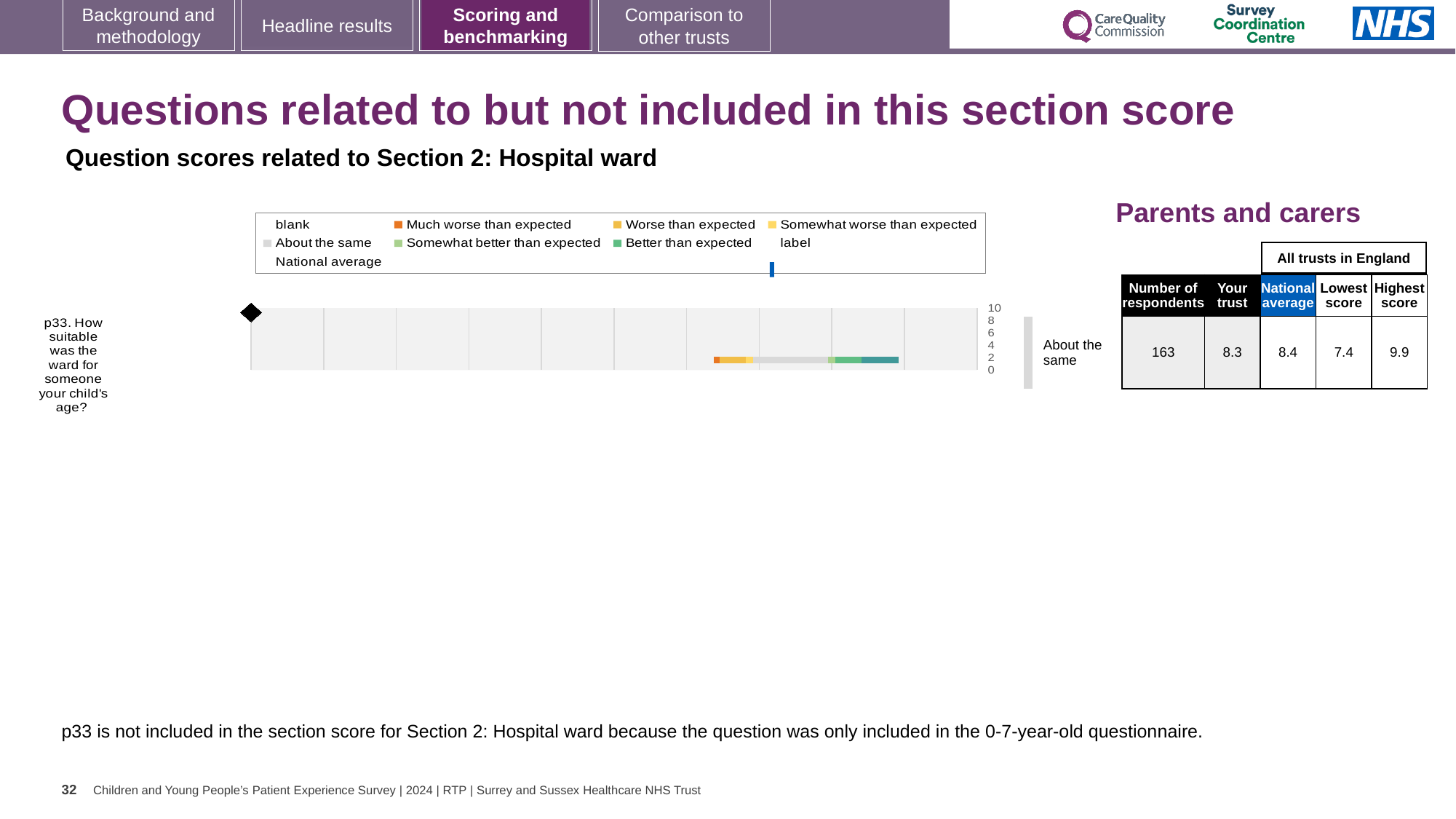
In the table beside the chart, what is the national average score for p33? 8.4 What is the highest value shown on the chart's axis? 10 Which question is plotted in the chart? p33. How suitable was the ward for someone your child's age? How many question categories are plotted in the chart? 1 In the table beside the chart, how many respondents answered p33? 163 Which is larger for p33, the 'Your trust' score or the national average? national average How many entries does the chart legend list? 9 What kind of chart is shown on the slide? bar chart In the table beside the chart, what is the 'Your trust' score for p33? 8.3 What benchmark category label is shown to the right of the chart for p33? About the same In the table beside the chart, what is the lowest score among all trusts in England for p33? 7.4 In the table beside the chart, what is the highest score among all trusts in England for p33? 9.9